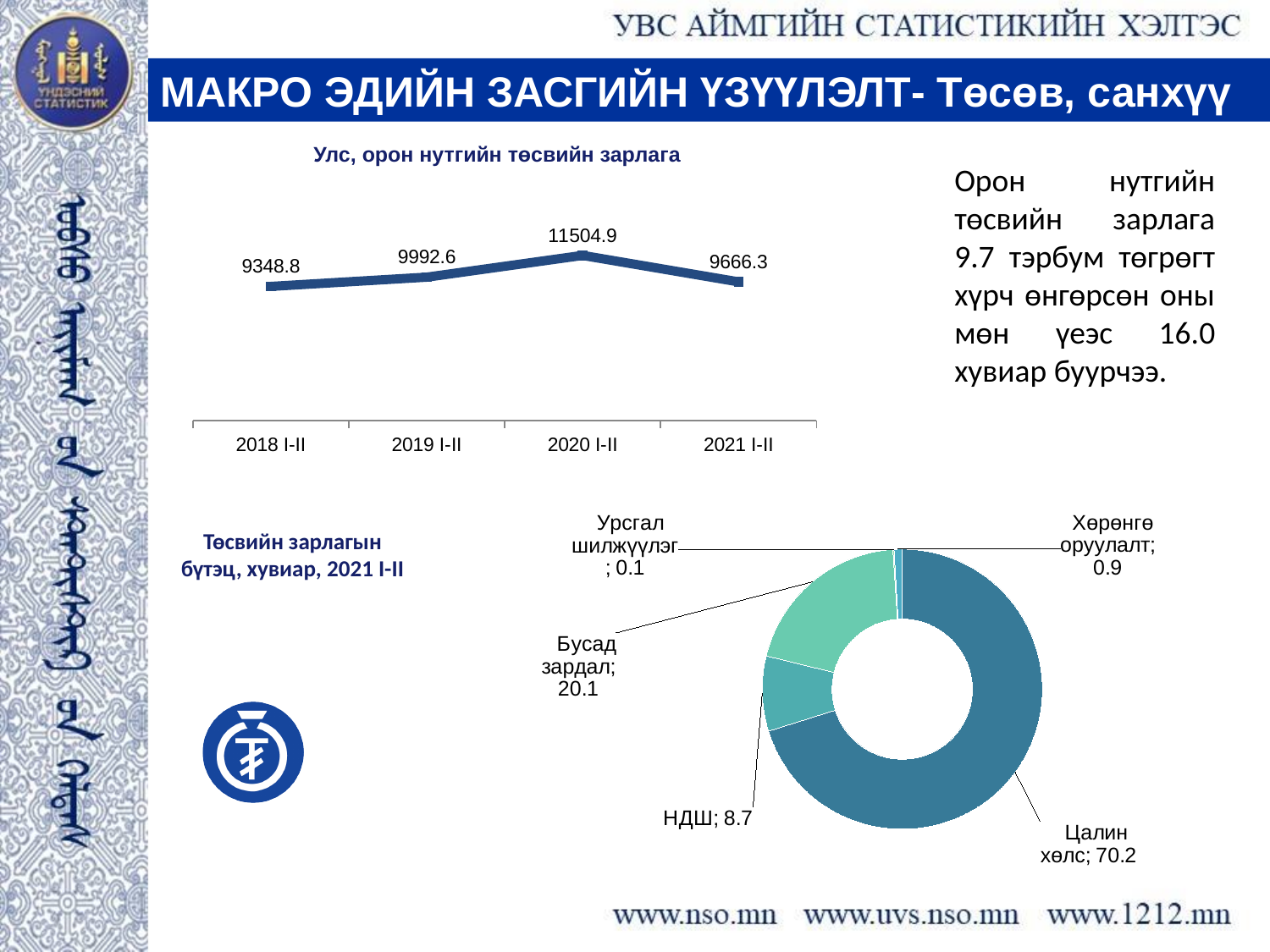
In the line chart 'Улс, орон нутгийн төсвийн зарлага', what is the difference between the 2020 I-II and 2021 I-II values? 1838.6 In the doughnut chart 'Төсвийн зарлагын бүтэц, хувиар, 2021 I-II', which is larger: НДШ or Хөрөнгө оруулалт? НДШ In the line chart 'Улс, орон нутгийн төсвийн зарлага', what is the value for 2018 I-II? 9348.8 In the line chart 'Улс, орон нутгийн төсвийн зарлага', which period has the highest value? 2020 I-II What type of chart is 'Улс, орон нутгийн төсвийн зарлага'? line chart In the line chart 'Улс, орон нутгийн төсвийн зарлага', which period has the lowest value? 2018 I-II In the doughnut chart 'Төсвийн зарлагын бүтэц, хувиар, 2021 I-II', which category has the smallest share? Урсгал шилжүүлэг In the doughnut chart 'Төсвийн зарлагын бүтэц, хувиар, 2021 I-II', what is the share for Бусад зардал? 20.1 In the line chart 'Улс, орон нутгийн төсвийн зарлага', what is the value for 2020 I-II? 11504.9 In the line chart 'Улс, орон нутгийн төсвийн зарлага', how many periods are plotted? 4 In the line chart 'Улс, орон нутгийн төсвийн зарлага', does the value rise or fall from 2020 I-II to 2021 I-II? fall In the doughnut chart 'Төсвийн зарлагын бүтэц, хувиар, 2021 I-II', what is the share for Цалин хөлс? 70.2